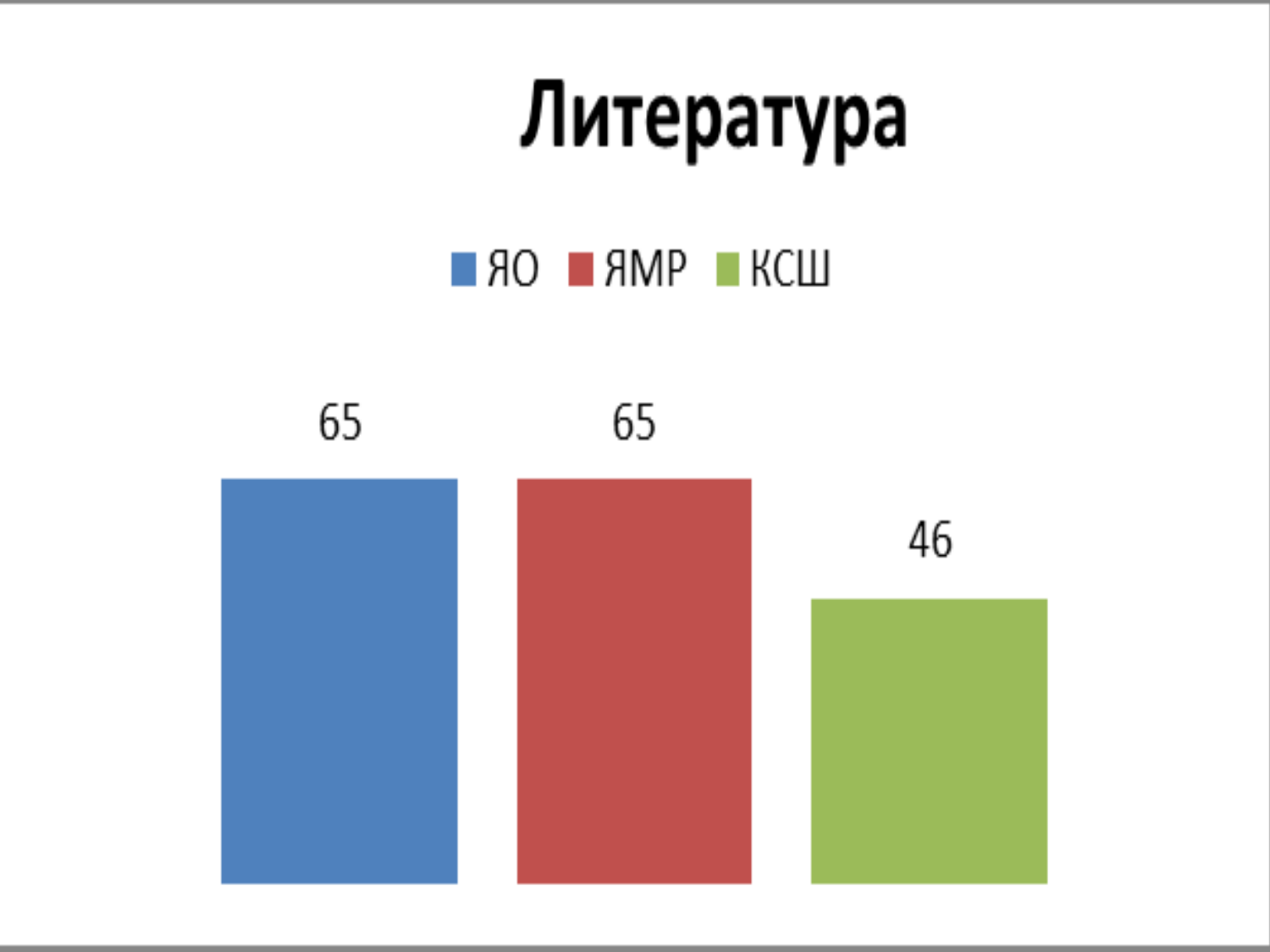
What colour is the bar for КСШ? green Which is larger, the value for ЯМР or the value for КСШ? ЯМР What is the difference between the values for ЯМР and КСШ? 19 How many bars are shown in the chart? 3 What kind of chart is shown on the slide? bar chart Which series has the lowest value? КСШ What is the title of the chart? Литература What is the difference between the values for ЯО and КСШ? 19 How many series does the legend list? 3 What is the value for ЯО? 65 What is the value for КСШ? 46 What is the value for ЯМР? 65